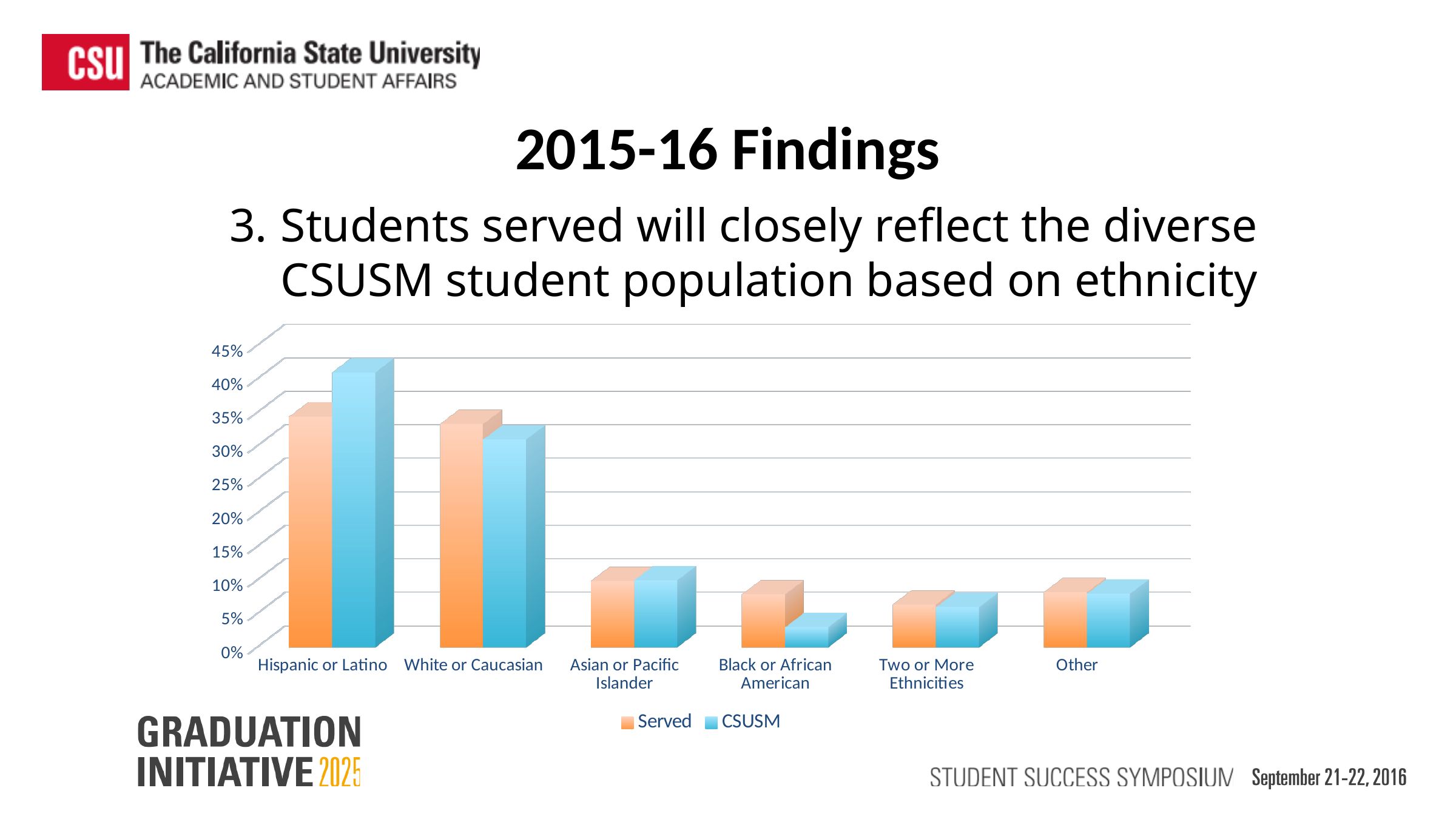
Is the CSUSM value for Black or African American greater or less than 5%? less What kind of chart is shown on the slide? bar chart Which category has the highest CSUSM value? Hispanic or Latino Is the CSUSM value for White or Caucasian greater or less than 25%? greater Which colour represents the Served series in the chart's legend? orange For Black or African American, which is larger: the Served value or the CSUSM value? Served How many series does the chart's legend list? 2 Is the Served value for Asian or Pacific Islander greater or less than 15%? less Which category has the lowest CSUSM value? Black or African American How many ethnicity categories are shown on the x axis of the chart? 6 For Hispanic or Latino, which is larger: the Served value or the CSUSM value? CSUSM